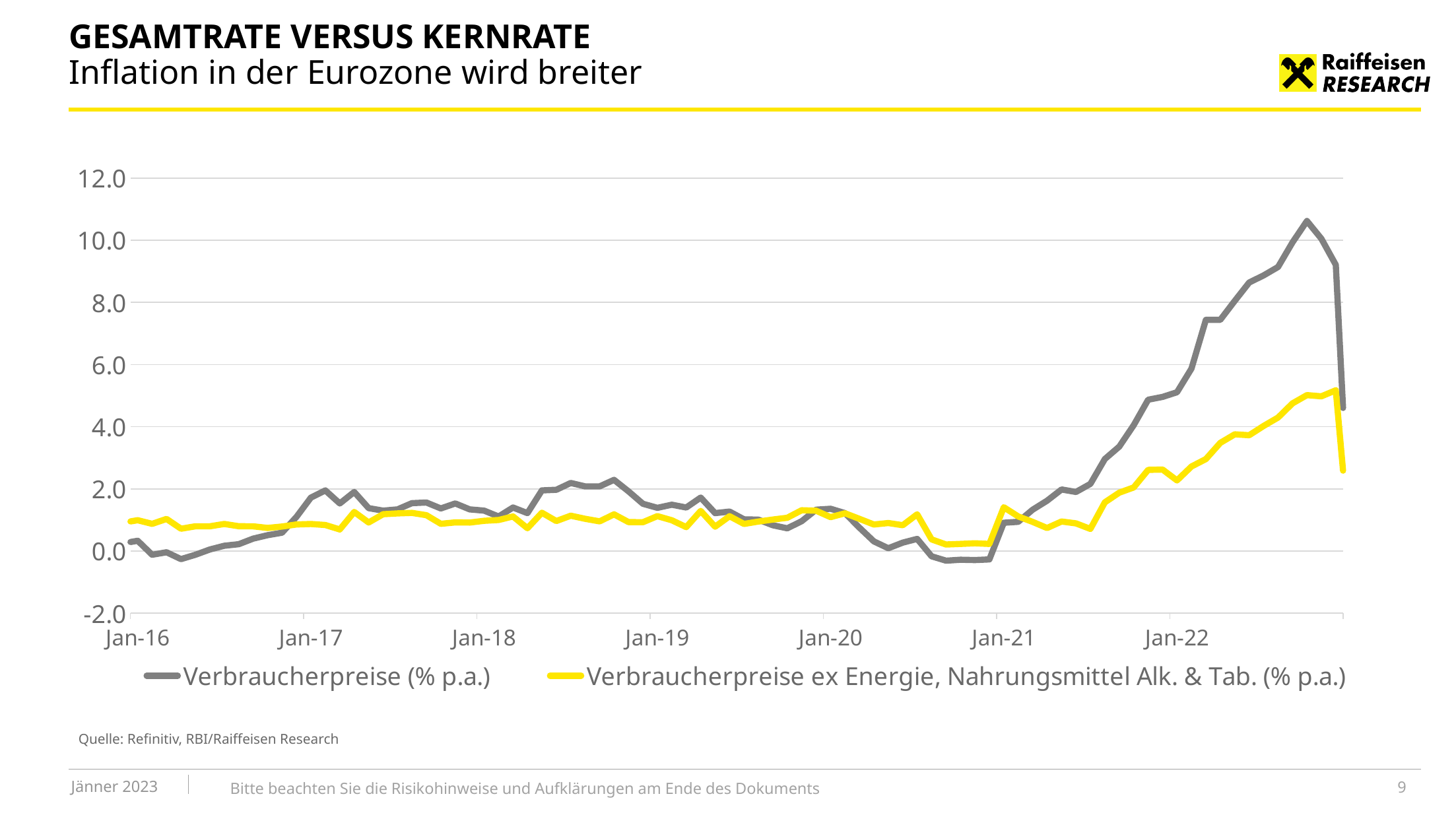
Which series is drawn in grey? Verbraucherpreise (% p.a.) Is the peak value of Verbraucherpreise (% p.a.) greater or less than 10.0? greater Between Jan-21 and Jan-22, does Verbraucherpreise (% p.a.) rise or fall? rise How many series does the legend list? 2 How many year labels are shown on the x axis? 7 At Jan-22, which series is higher, Verbraucherpreise (% p.a.) or Verbraucherpreise ex Energie, Nahrungsmittel Alk. & Tab. (% p.a.)? Verbraucherpreise (% p.a.) What kind of chart is shown on the slide? line chart Is the value of Verbraucherpreise (% p.a.) at Jan-16 greater or less than 2.0? less Which series reaches the highest value on the chart? Verbraucherpreise (% p.a.) Is the peak value of Verbraucherpreise ex Energie, Nahrungsmittel Alk. & Tab. (% p.a.) greater or less than 6.0? less Which series is drawn in yellow? Verbraucherpreise ex Energie, Nahrungsmittel Alk. & Tab. (% p.a.)